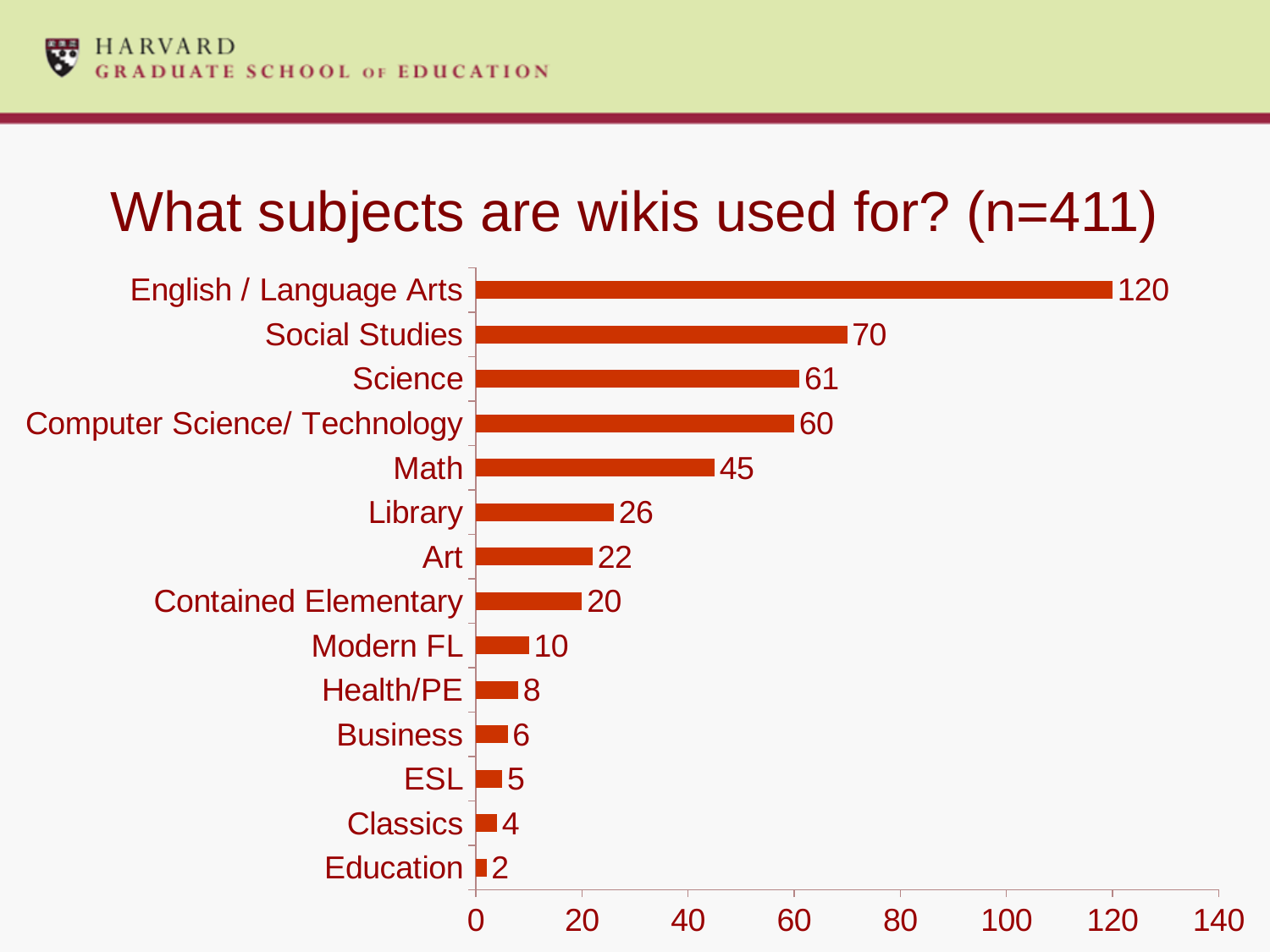
What is the value for Math? 45 What kind of chart is shown on the slide? Bar chart Which is larger, the value for Science or the value for Math? Science What is the value for Contained Elementary? 20 What is the difference between the values for Library and Art? 4 What is the value for Social Studies? 70 Is the value for Computer Science/ Technology greater or less than 80? less How many subjects are shown in the chart? 14 What is the title of the chart? What subjects are wikis used for? (n=411) Which subject has the highest value? English / Language Arts What is the difference between the values for English / Language Arts and Social Studies? 50 Which subject has the lowest value? Education